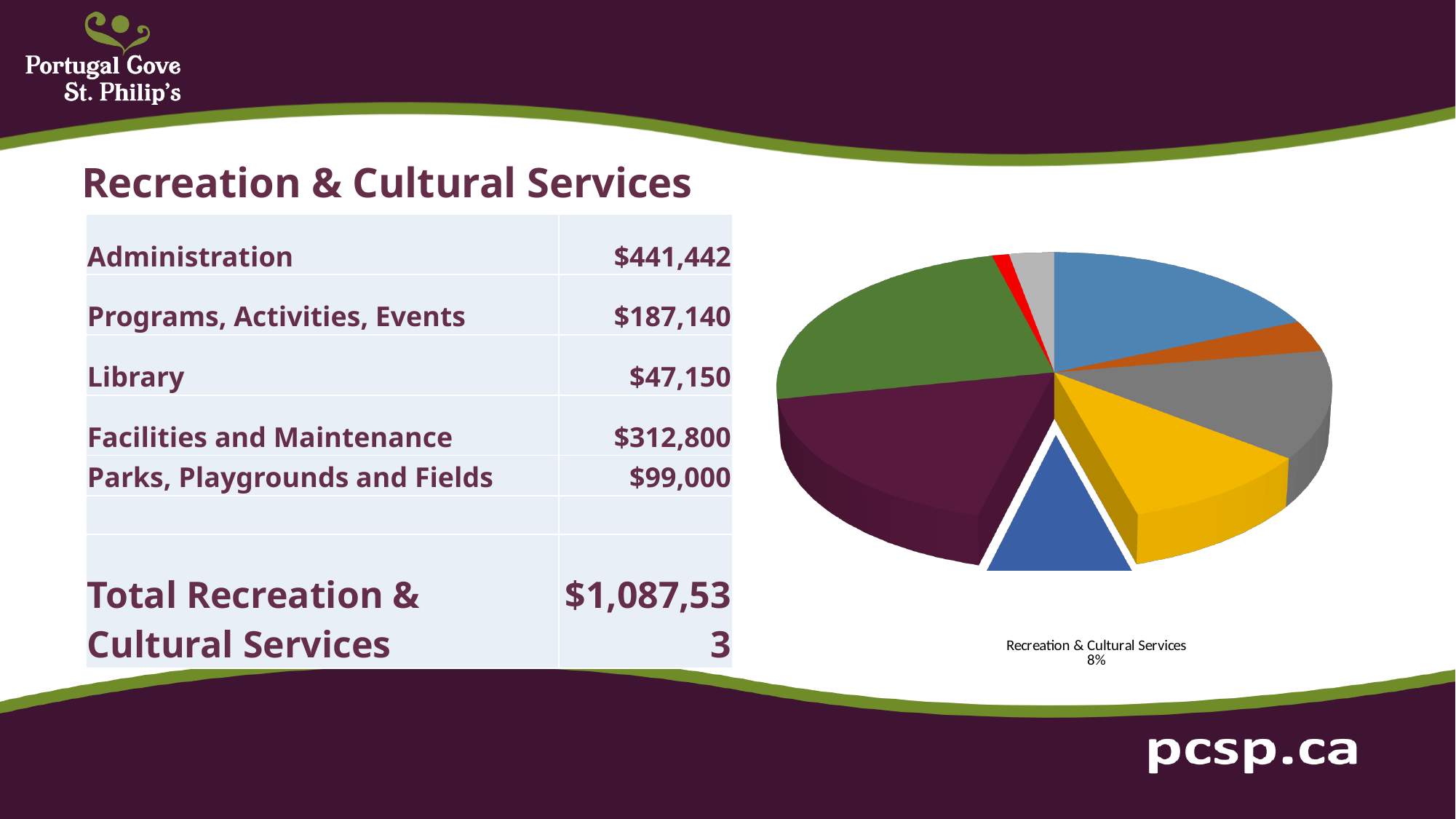
What share of the pie is labelled for Recreation & Cultural Services? 8% Which slice of the pie chart is the smallest? the red slice What colour is the slice that is pulled out from the rest of the pie chart? blue What kind of chart is shown on the right side of the slide? pie chart What is the only data label printed on the pie chart? Recreation & Cultural Services 8% How many slices does the pie chart have? 9 Which slice of the pie chart is the largest? the green slice Is the purple slice of the pie chart larger or smaller than the yellow slice? larger